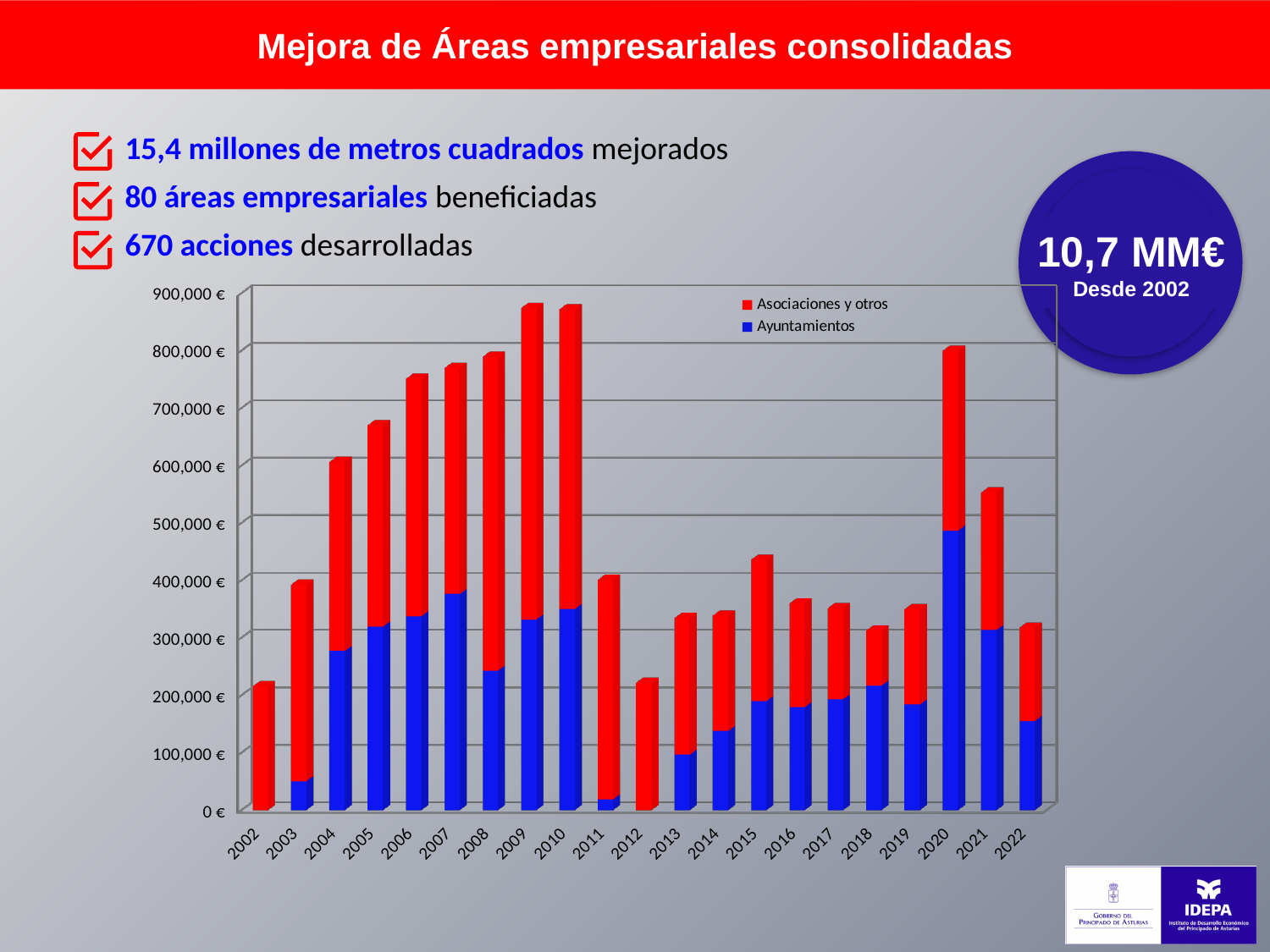
Is the total value for 2004 greater or less than 500,000 €? greater Is the total value for 2012 greater or less than 300,000 €? less Do the total bar values rise or fall from 2004 to 2009? rise Which series is shown in blue in the chart? Ayuntamientos How many years are shown on the x axis of the chart? 21 What kind of chart is shown on the slide? stacked bar chart Is the total value for 2020 greater or less than 700,000 €? greater Which series is shown in red in the chart? Asociaciones y otros Which year has the larger total bar, 2003 or 2005? 2005 How many series does the chart legend list? 2 Which year has the larger total bar, 2020 or 2021? 2020